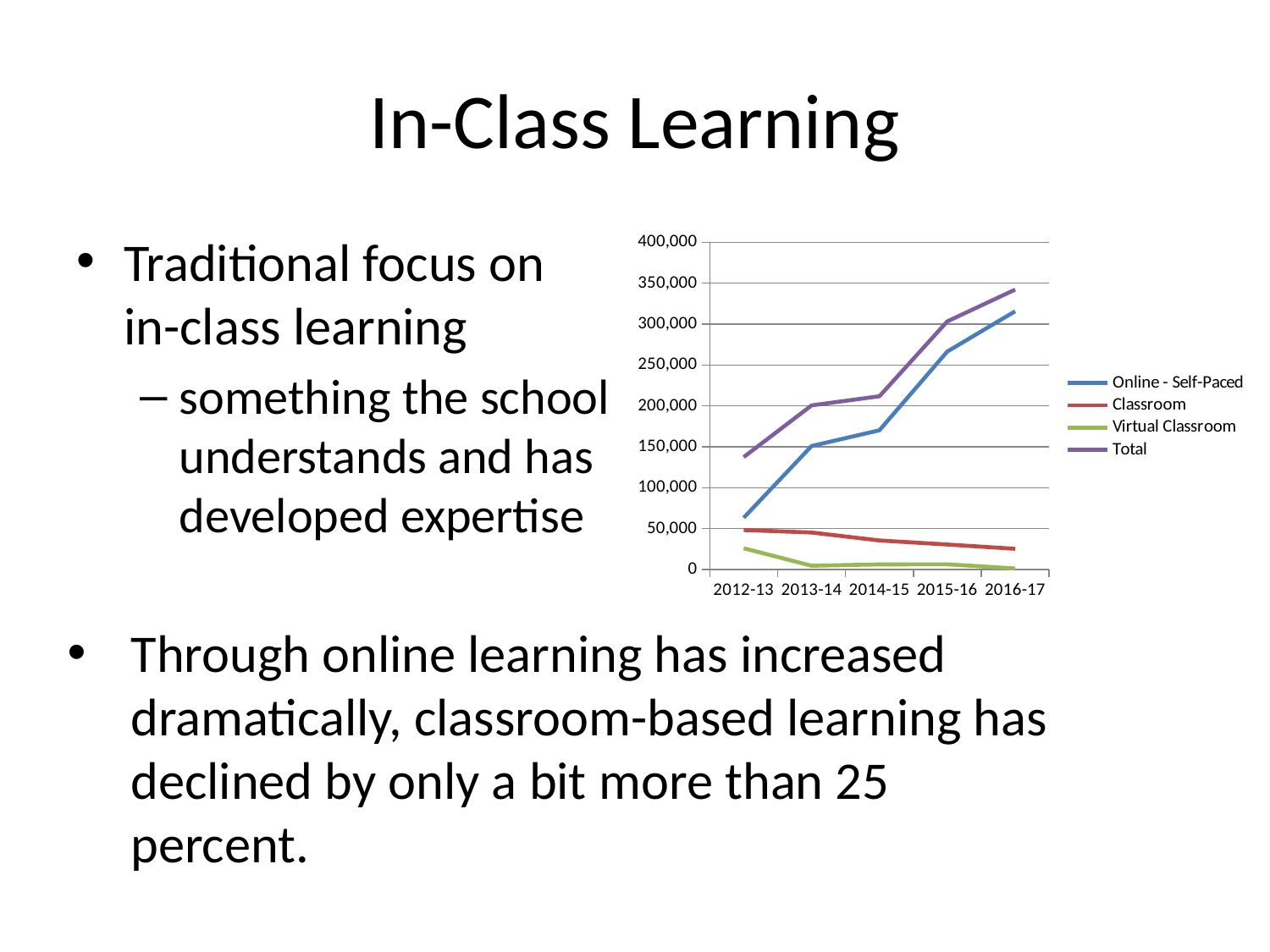
In which year is the Total series at its highest? 2016-17 Is the Classroom value for 2016-17 greater or less than 50,000? less What kind of chart is shown on the slide? line chart Does the Online - Self-Paced line rise or fall from 2012-13 to 2016-17? rise In 2012-13, which is larger: the Classroom value or the Online - Self-Paced value? Online - Self-Paced How many series does the chart's legend list? 4 Is the Total value for 2016-17 greater or less than 300,000? greater Does the Classroom line rise or fall from 2012-13 to 2016-17? fall Is the Online - Self-Paced value for 2012-13 greater or less than 50,000? greater How many academic years are shown on the x axis of the chart? 5 Which series has the lowest value in 2016-17? Virtual Classroom